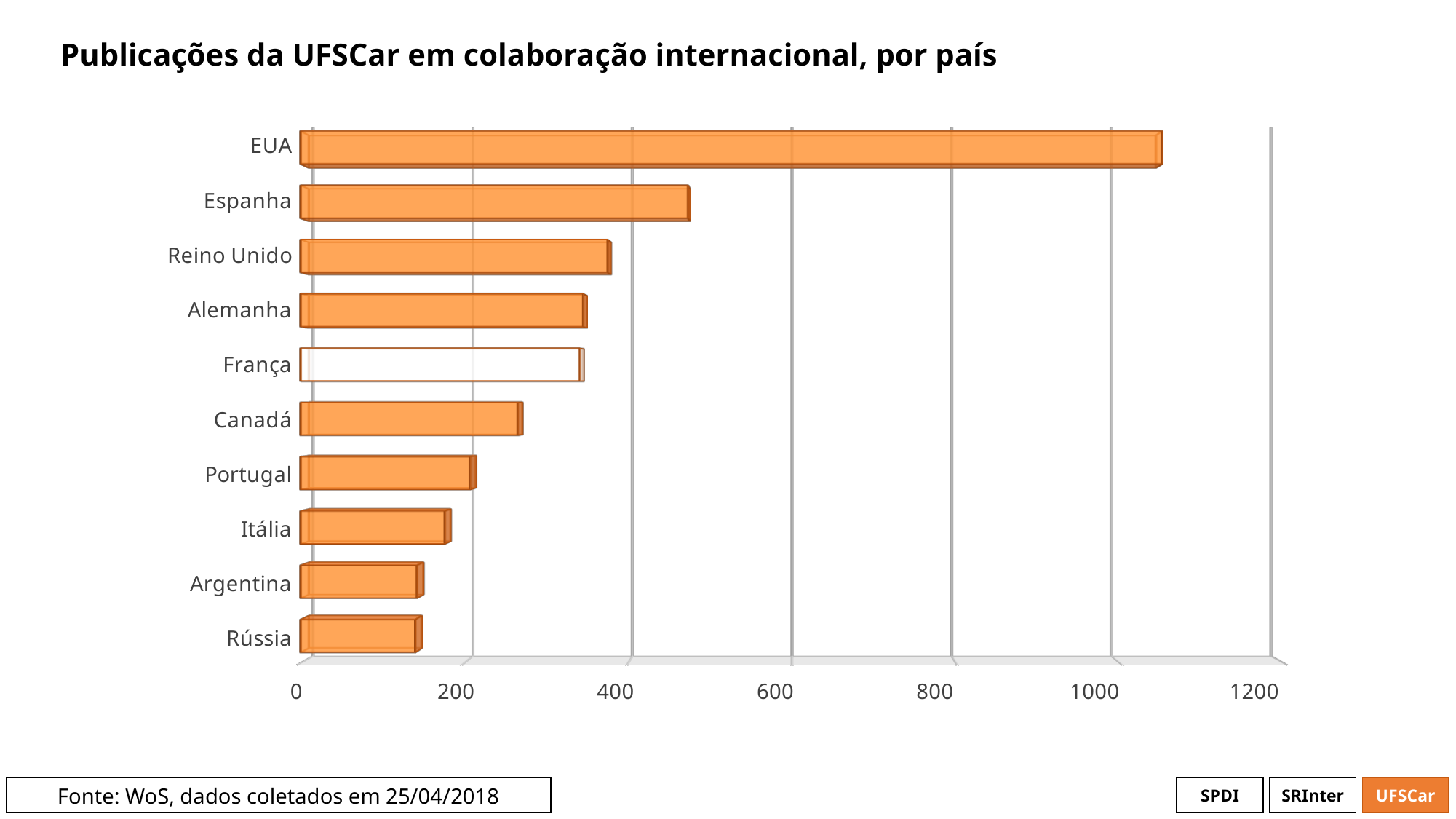
Is the value for Rússia greater or less than 200? less Is the value for Itália greater or less than 200? less What kind of chart is shown on the slide? bar chart How many countries are shown in the chart? 10 Which has more publications, Espanha or Reino Unido? Espanha Which country has the highest number of publications in international collaboration with UFSCar? EUA Is the value for Espanha greater or less than 400? greater Which has more publications, Canadá or Portugal? Canadá Which country's bar is drawn unfilled (white) instead of orange? França